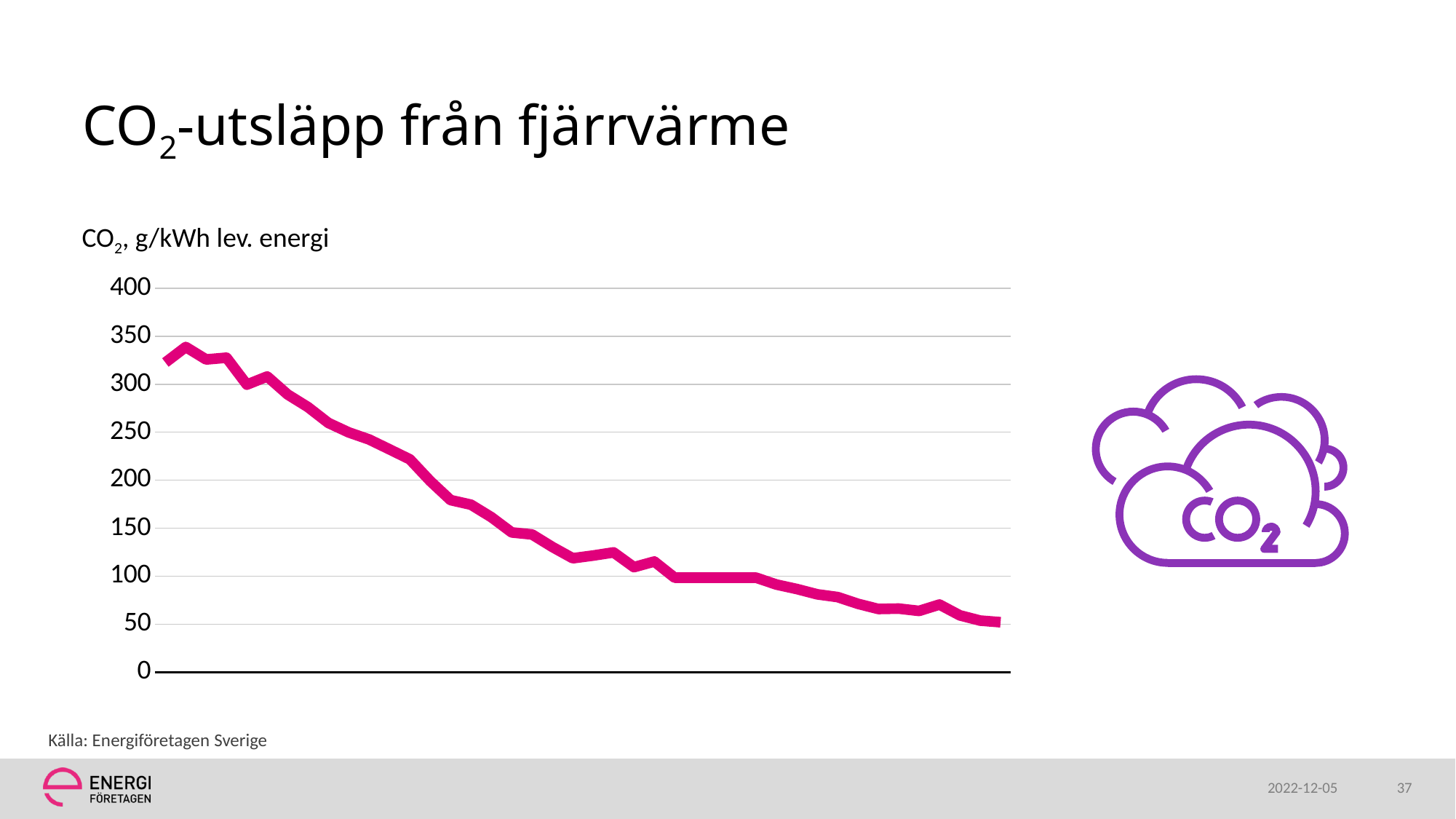
Is the highest point of the line greater or less than 300? greater What kind of chart is shown on the slide? line chart What is the highest value shown on the vertical axis? 400 What unit label is shown above the chart's vertical axis? CO2, g/kWh lev. energi Is the highest point of the line greater or less than 400? less Is the value at the end (rightmost point) of the line greater or less than 100? less Do the values in the chart generally rise or fall from left to right? fall Which end of the line is higher, the left end or the right end? the left end